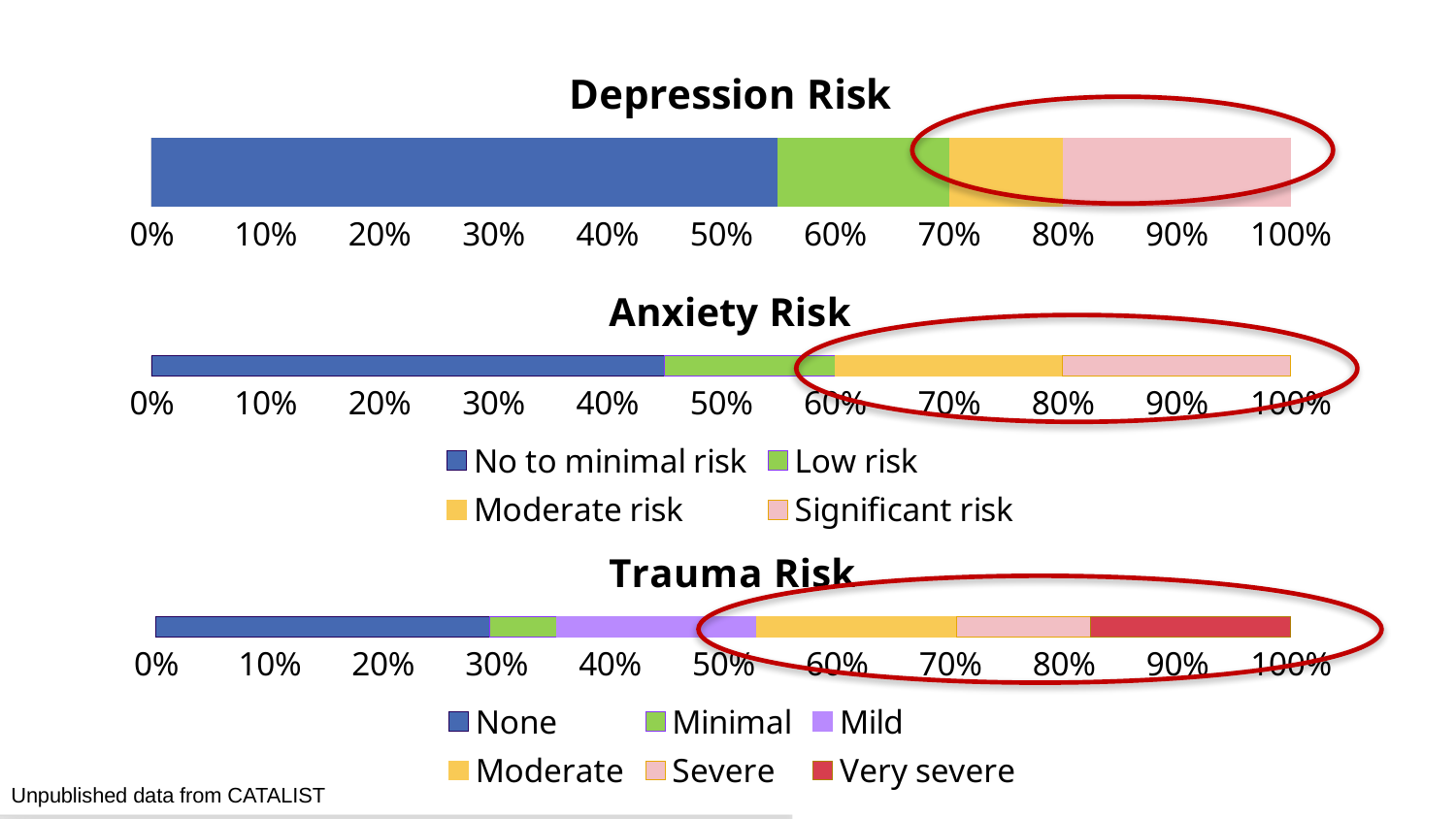
How many series does the legend below the Anxiety Risk chart list? 4 In the Depression Risk chart, is the share for No to minimal risk greater or less than 50%? greater In the Trauma Risk chart, which category has the smallest segment? Minimal In the Trauma Risk chart, is the share for None greater or less than 40%? less Which chart has the larger No to minimal risk segment, Depression Risk or Anxiety Risk? Depression Risk In the Trauma Risk chart, which segment is larger, Very severe or Minimal? Very severe In the Depression Risk chart, which risk category has the largest segment? No to minimal risk In the Anxiety Risk chart, is the share for No to minimal risk greater or less than 50%? less What kind of chart is the Depression Risk chart? Stacked bar chart How many charts are shown on the slide? 3 How many series does the legend below the Trauma Risk chart list? 6